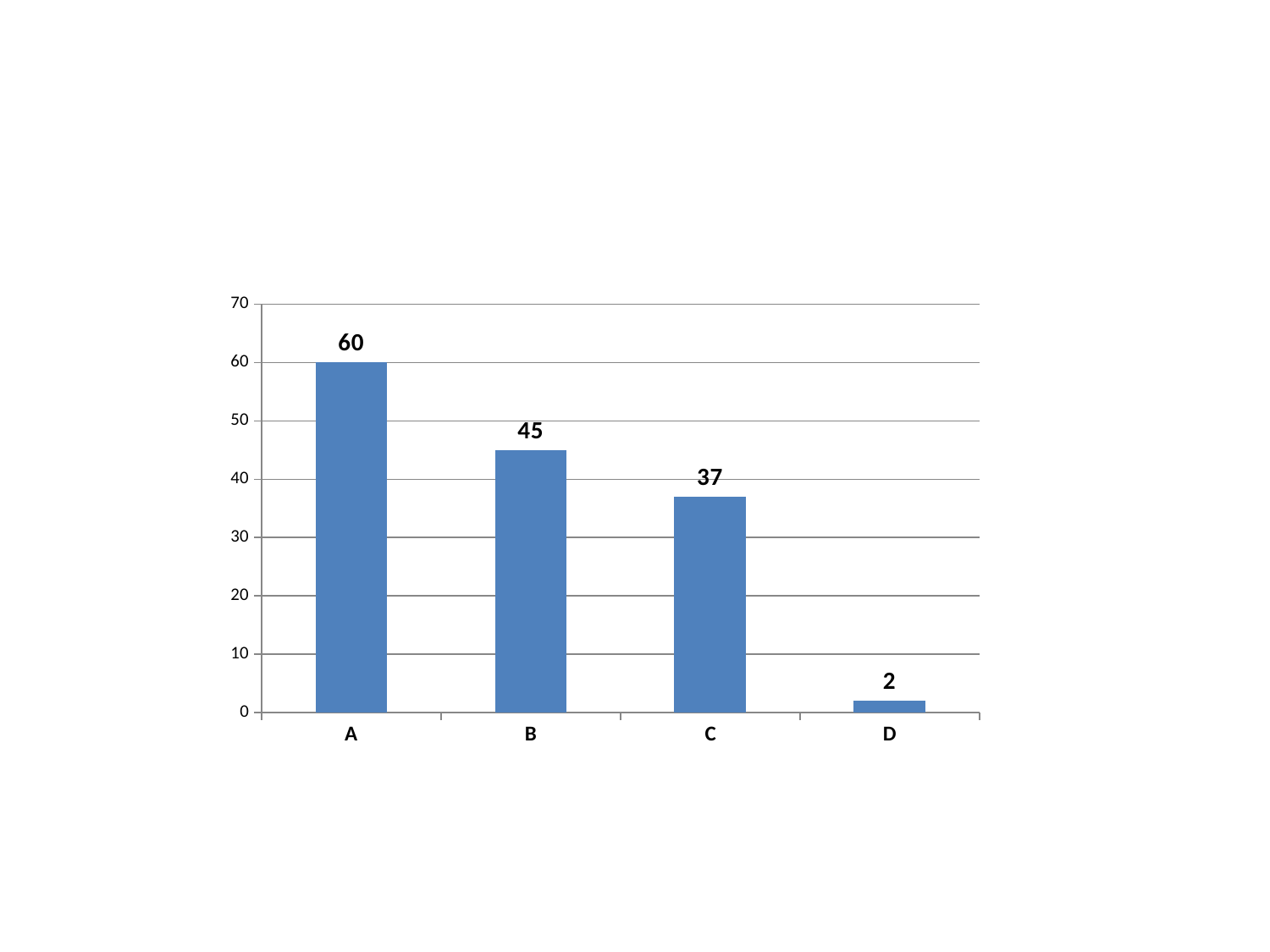
Which category has the highest value? A What is the value for category B? 45 Which category has the lowest value? D Do the values rise or fall from A to D along the x axis? Fall What is the value for category C? 37 What is the value for category D? 2 What kind of chart is this? Bar chart What is the difference between the values for A and B? 15 How many categories are shown on the x axis? 4 What is the value for category A? 60 What is the difference between the values for C and D? 35 Which is larger, the value for B or the value for C? B